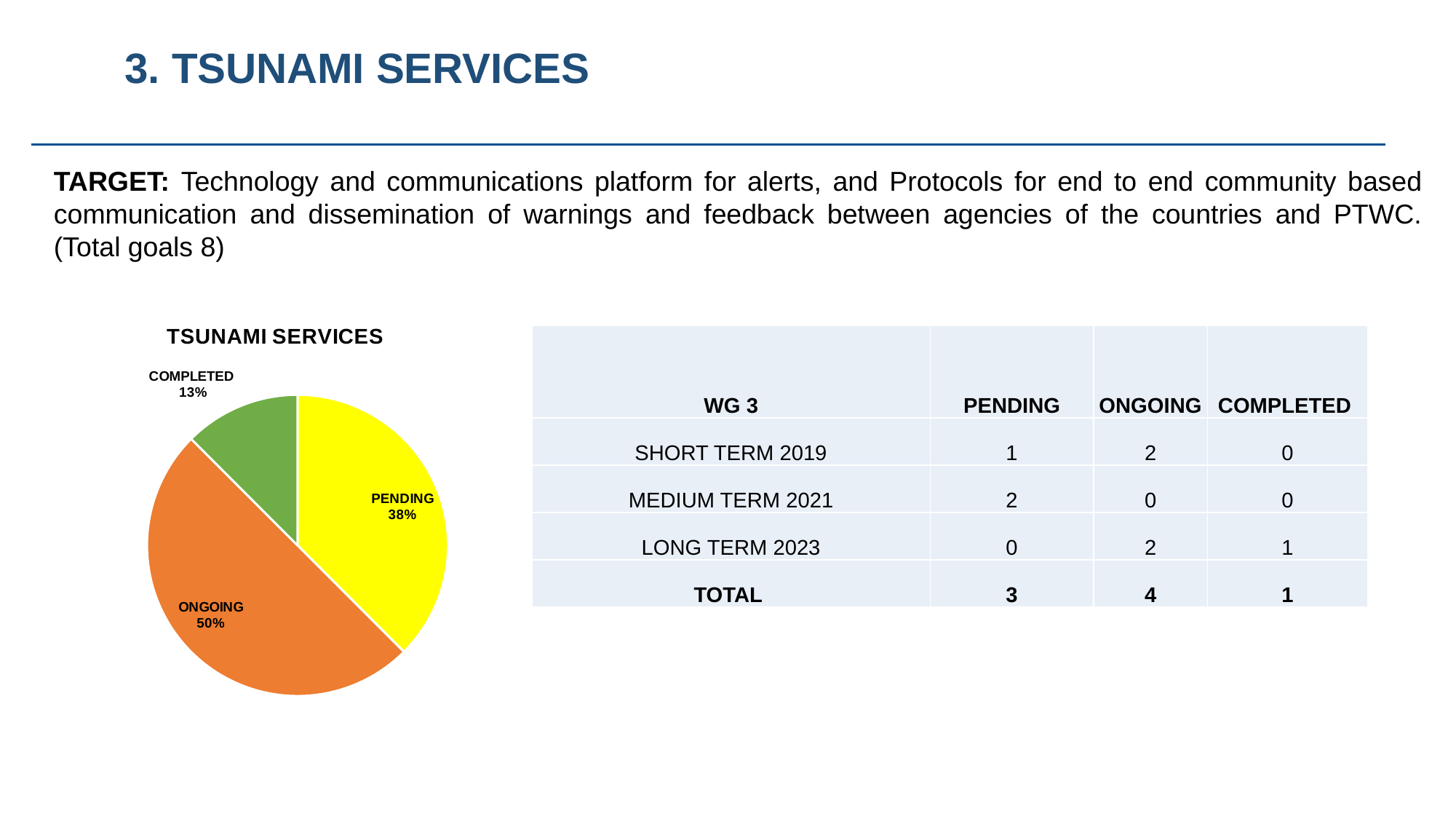
What colour is the ONGOING slice of the pie? orange What share of the pie does the PENDING slice represent? 38% What share of the pie does the COMPLETED slice represent? 13% Which slice of the pie is the largest? ONGOING What is the difference in percentage points between the PENDING and COMPLETED slices? 25% Which is larger, the PENDING slice or the COMPLETED slice? PENDING How many slices does the pie chart have? 3 What share of the pie does the ONGOING slice represent? 50% Which slice of the pie is the smallest? COMPLETED What is the difference in percentage points between the ONGOING and PENDING slices? 12% What kind of chart is shown on the slide? pie chart What is the title of the chart? TSUNAMI SERVICES